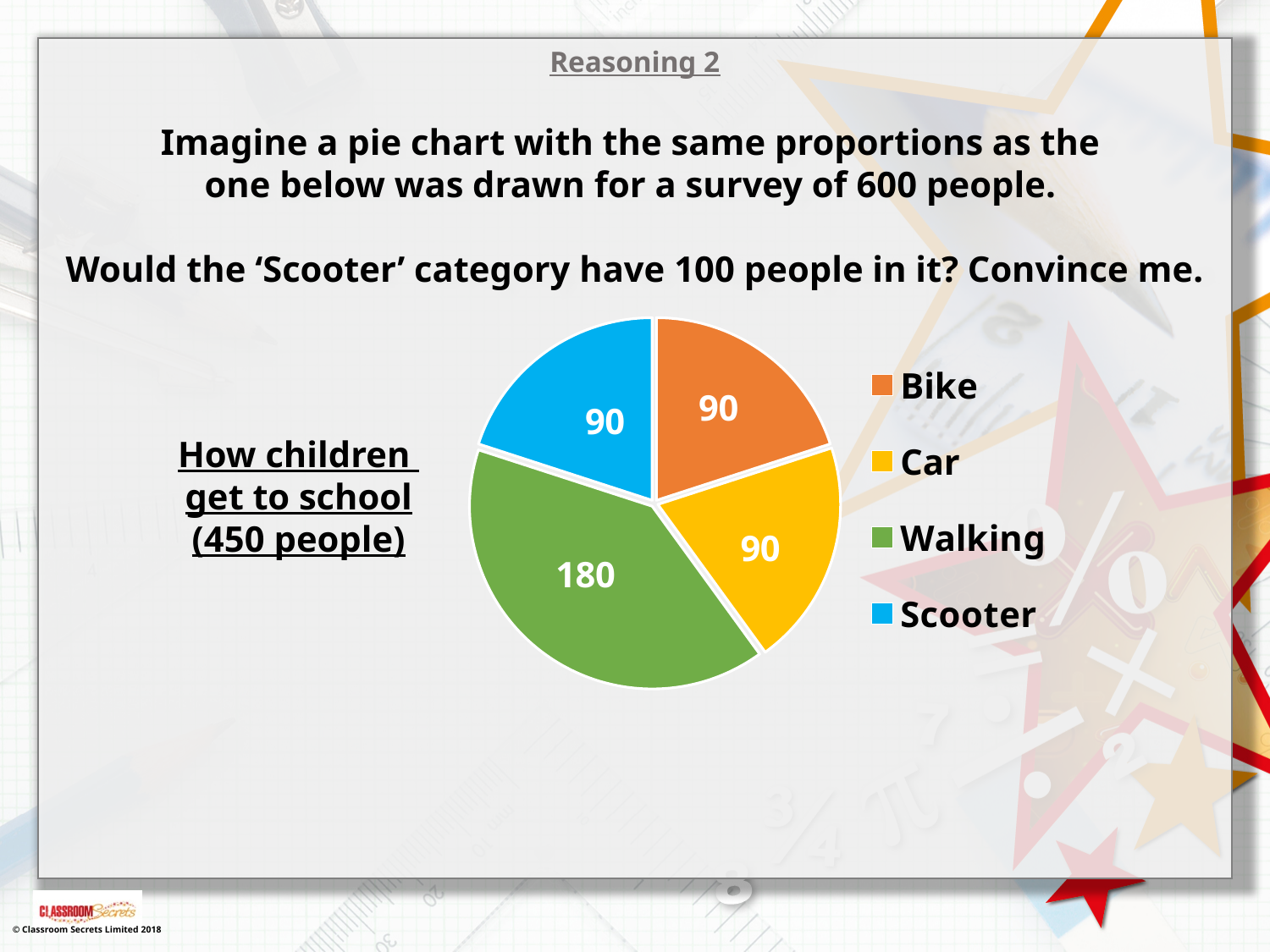
What share of the pie does the Walking slice represent? 40% What is the value for Scooter in the pie chart? 90 What is the value for Walking in the pie chart? 180 What share of the pie does the Scooter slice represent? 20% Which category has the largest slice in the pie chart? Walking How many categories does the pie chart show? 4 What colour is the Scooter slice in the pie chart? blue What type of chart is shown on the slide? pie chart What is the total of all the slices in the pie chart? 450 What is the value for Bike in the pie chart? 90 What is the difference between the values for Walking and Car? 90 Which is larger, the value for Walking or the value for Bike? Walking